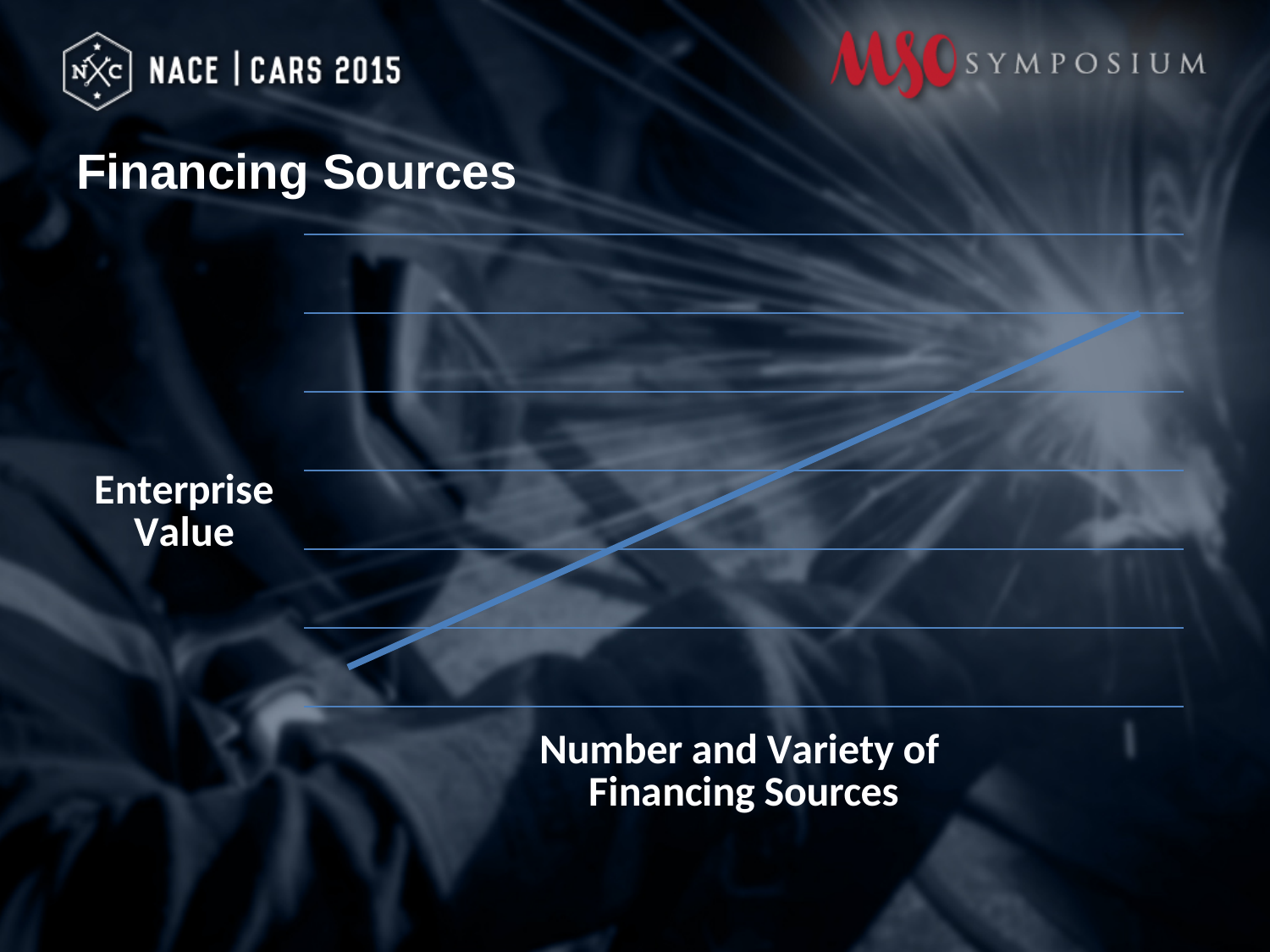
What kind of chart is shown on the slide? line chart According to the chart, as the number and variety of financing sources increases, does enterprise value increase or decrease? increase What is the label on the horizontal (x) axis of the chart? Number and Variety of Financing Sources What is the label on the vertical (y) axis of the chart? Enterprise Value Does the plotted line rise or fall as you move from left to right along the x axis? rise